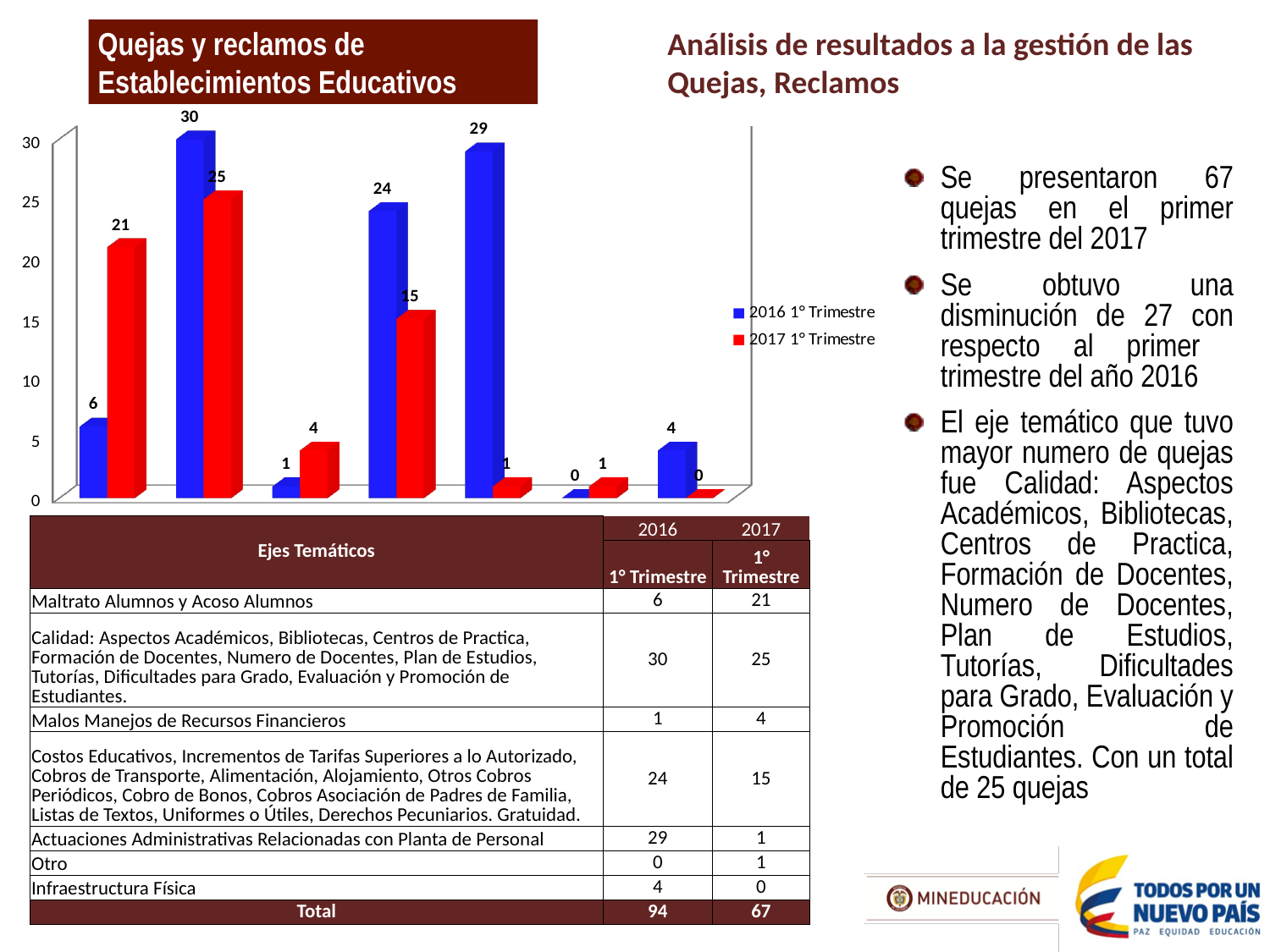
What kind of chart is shown on the slide? bar chart In the second group of bars, what is the difference between the 2016 1° Trimestre value (30) and the 2017 1° Trimestre value (25)? 5 In the fourth group of bars, what is the difference between the 2016 1° Trimestre value (24) and the 2017 1° Trimestre value (15)? 9 How many groups of bars (categories) are plotted in the chart? 7 In the fifth group of bars, which series has the larger value, 2016 1° Trimestre or 2017 1° Trimestre? 2016 1° Trimestre What is the highest value shown for the 2016 1° Trimestre series in the chart? 30 In the first group of bars, what is the value of the 2017 1° Trimestre bar? 21 Which colour represents the 2017 1° Trimestre series in the chart? red How many series does the chart legend list? 2 What are the two series named in the chart legend? 2016 1° Trimestre and 2017 1° Trimestre What is the highest value shown for the 2017 1° Trimestre series in the chart? 25 In the first group of bars, what is the value of the 2016 1° Trimestre bar? 6